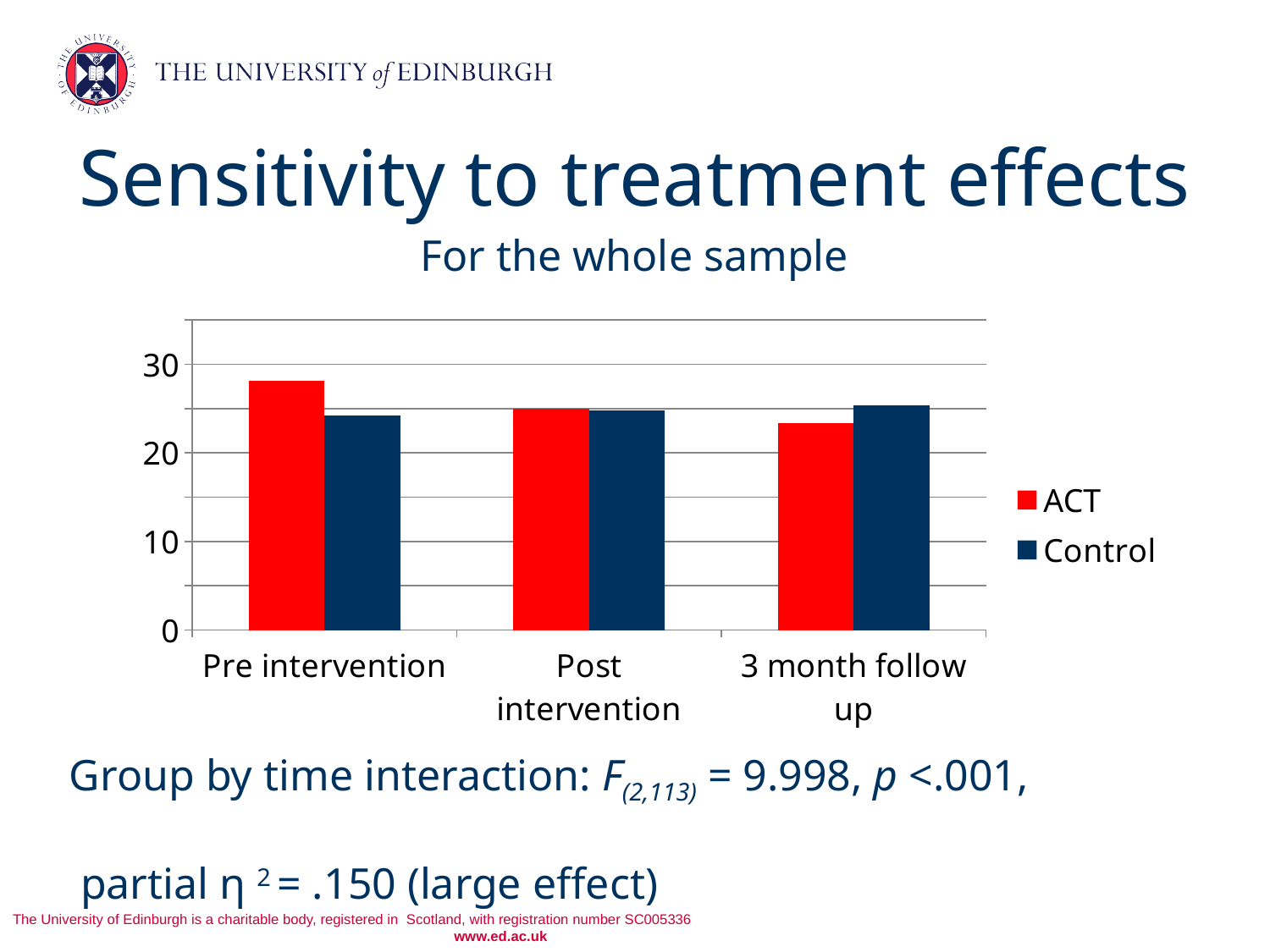
How many time points (categories) are shown on the x axis? 3 What are the two series named in the legend? ACT and Control Is the Control value at 3 month follow up greater or less than 20? greater At which time point is the ACT value highest? Pre intervention At 3 month follow up, which group has the larger value, ACT or Control? Control At Pre intervention, which group has the larger value, ACT or Control? ACT Is the ACT value at Pre intervention greater or less than 30? less Do the ACT values rise or fall from Pre intervention to 3 month follow up? fall Which series is shown in red? ACT How many series does the legend list? 2 What kind of chart is shown on the slide? bar chart At which time point is the ACT value lowest? 3 month follow up